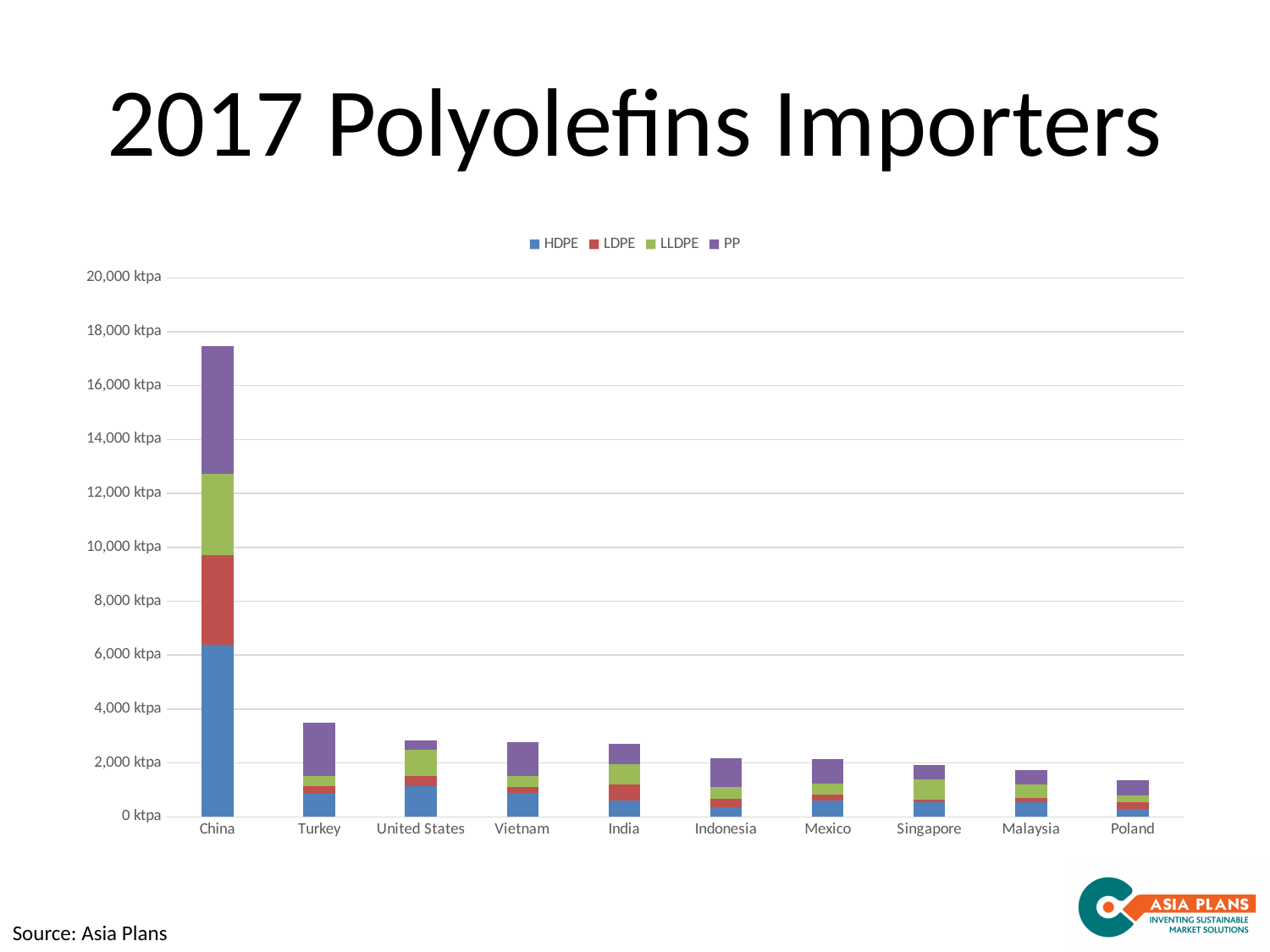
Is the total value for Turkey greater or less than 4,000 ktpa? less Which series is shown in purple in the legend? PP Is the total value for the United States greater or less than 2,000 ktpa? greater Which country has the lowest total polyolefins imports in the chart? Poland How many series does the legend list? 4 What kind of chart is shown on the slide? stacked bar chart How many countries are shown on the x axis of the chart? 10 Is the total value for Poland greater or less than 2,000 ktpa? less Which has a larger total, China or Turkey? China Which country has the highest total polyolefins imports in the chart? China Do the total bar heights generally rise or fall from left to right along the x axis? fall